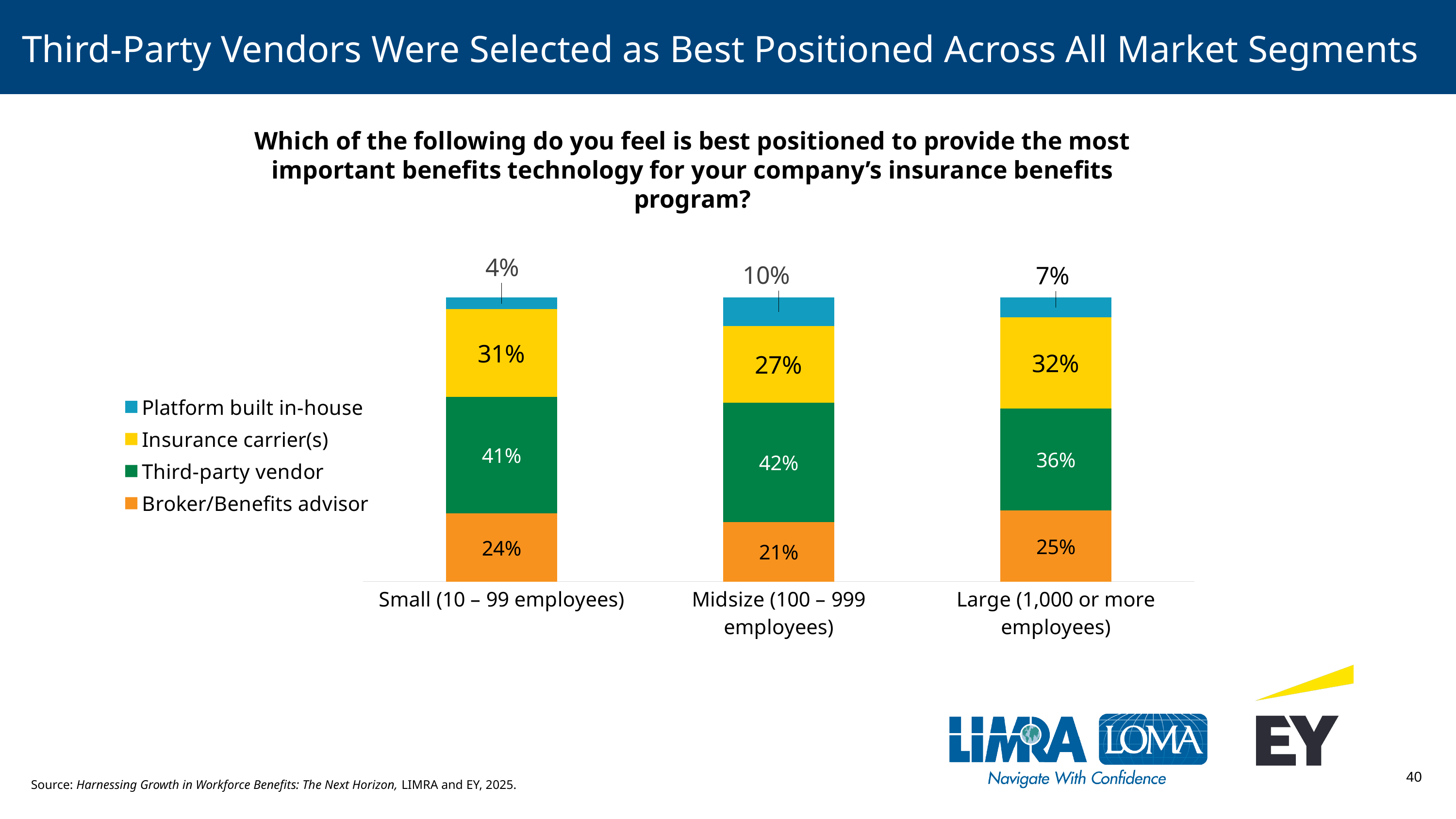
How many market segments are shown on the x axis? 3 How many series does the legend list? 4 Which market segment has the lowest share for Third-party vendor? Large (1,000 or more employees) What is the total of the stacked bar for Large (1,000 or more employees)? 100% What percentage of Large (1,000 or more employees) companies selected Insurance carrier(s)? 32% What kind of chart is shown on the slide? Stacked bar chart What percentage of Small (10 – 99 employees) companies selected Third-party vendor? 41% Which market segment has the highest share for Platform built in-house? Midsize (100 – 999 employees) What percentage of Midsize (100 – 999 employees) companies selected Platform built in-house? 10% Which is larger for Small companies: the Insurance carrier(s) share or the Broker/Benefits advisor share? Insurance carrier(s) What is the difference between the Third-party vendor share for Midsize and Large companies? 6% What percentage of Midsize (100 – 999 employees) companies selected Broker/Benefits advisor? 21%